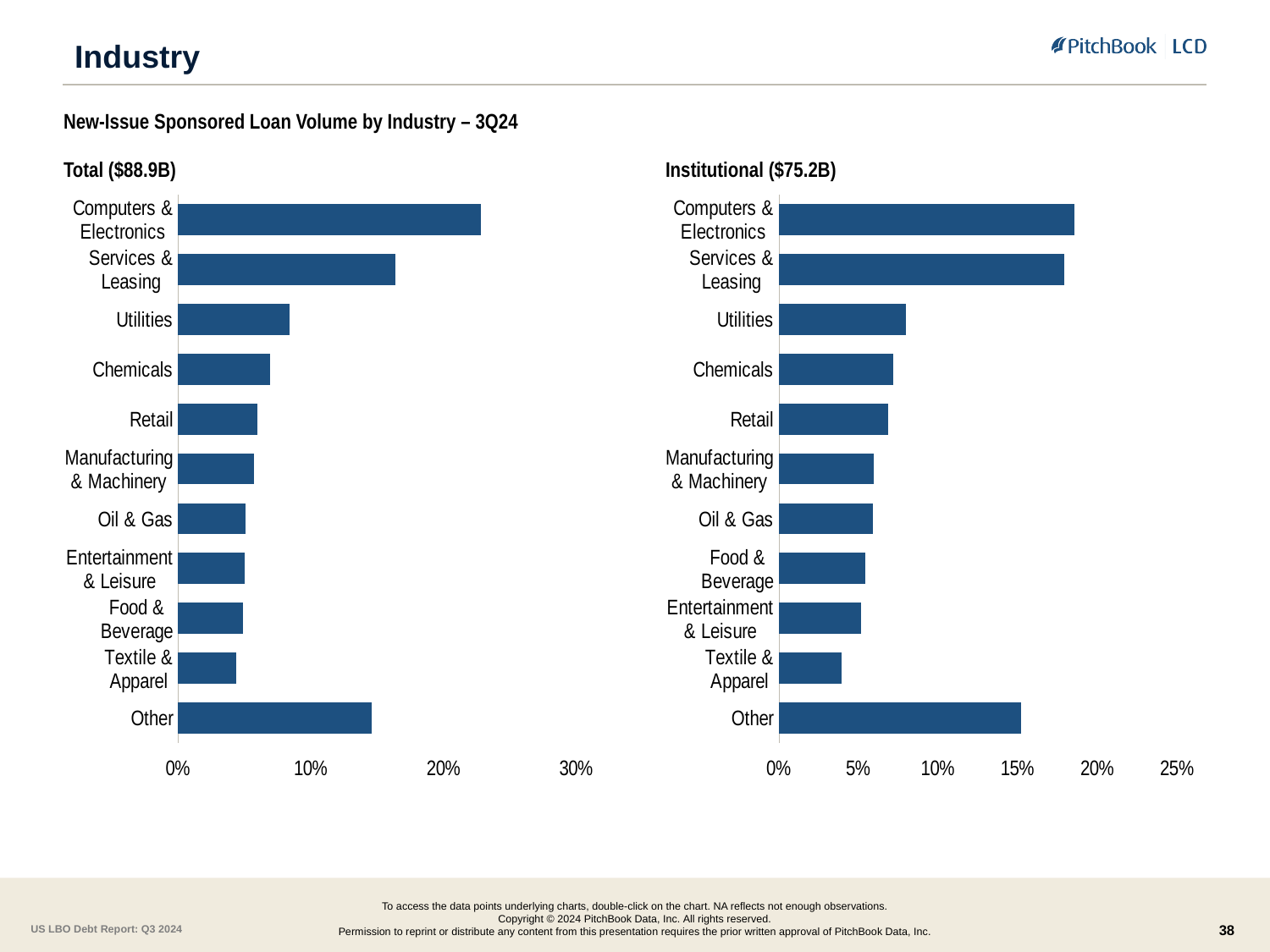
What is the title of the chart on the right side of the slide? Institutional ($75.2B) In the Institutional ($75.2B) chart, which is larger, Utilities or Textile & Apparel? Utilities In the Total ($88.9B) chart, how many industry categories are plotted? 11 In the Total ($88.9B) chart, is the value for Utilities greater or less than 10%? less In the Total ($88.9B) chart, is the value for Computers & Electronics greater or less than 20%? greater In the Institutional ($75.2B) chart, is the value for Other greater or less than 10%? greater In the Total ($88.9B) chart, which industry has the highest share? Computers & Electronics In the Total ($88.9B) chart, what kind of chart is shown? bar chart In the Institutional ($75.2B) chart, which industry has the lowest share? Textile & Apparel In the Total ($88.9B) chart, which industry has the lowest share? Textile & Apparel In the Total ($88.9B) chart, which is larger, Services & Leasing or Other? Services & Leasing